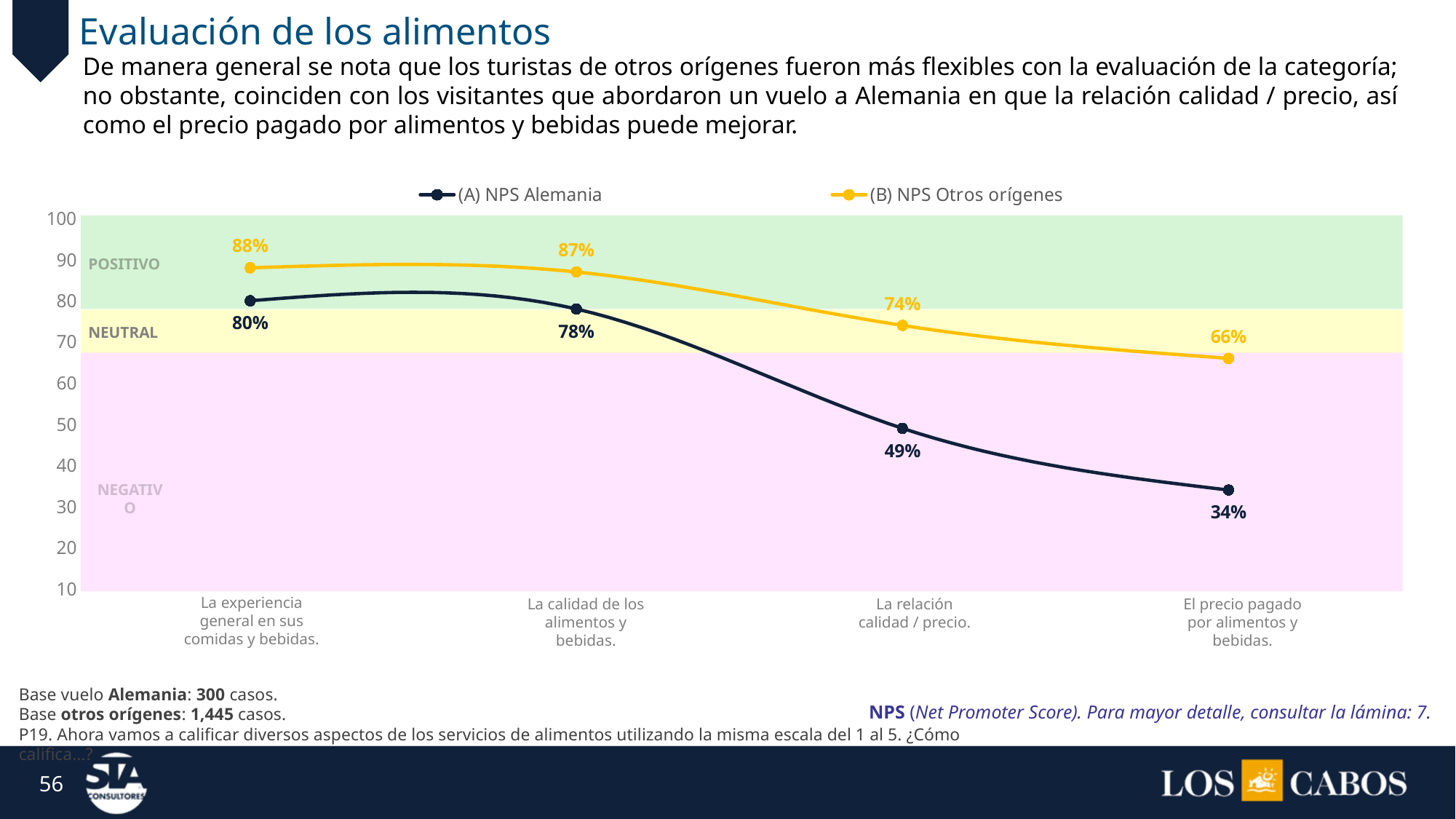
How many categories are shown on the x axis? 4 Which category has the lowest value for (A) NPS Alemania? El precio pagado por alimentos y bebidas. What is the value of (B) NPS Otros orígenes for "La experiencia general en sus comidas y bebidas."? 88% What is the value of (B) NPS Otros orígenes for "La calidad de los alimentos y bebidas."? 87% What kind of chart is shown on the slide? Line chart Do the values for (A) NPS Alemania rise or fall from left to right along the x axis? Fall Which category has the highest value for (B) NPS Otros orígenes? La experiencia general en sus comidas y bebidas. What is the difference between (B) NPS Otros orígenes and (A) NPS Alemania for "La relación calidad / precio."? 25% Which series has the larger value for "El precio pagado por alimentos y bebidas."? (B) NPS Otros orígenes What is the value of (A) NPS Alemania for "La relación calidad / precio."? 49% How many series does the legend list? 2 What is the value of (A) NPS Alemania for "El precio pagado por alimentos y bebidas."? 34%